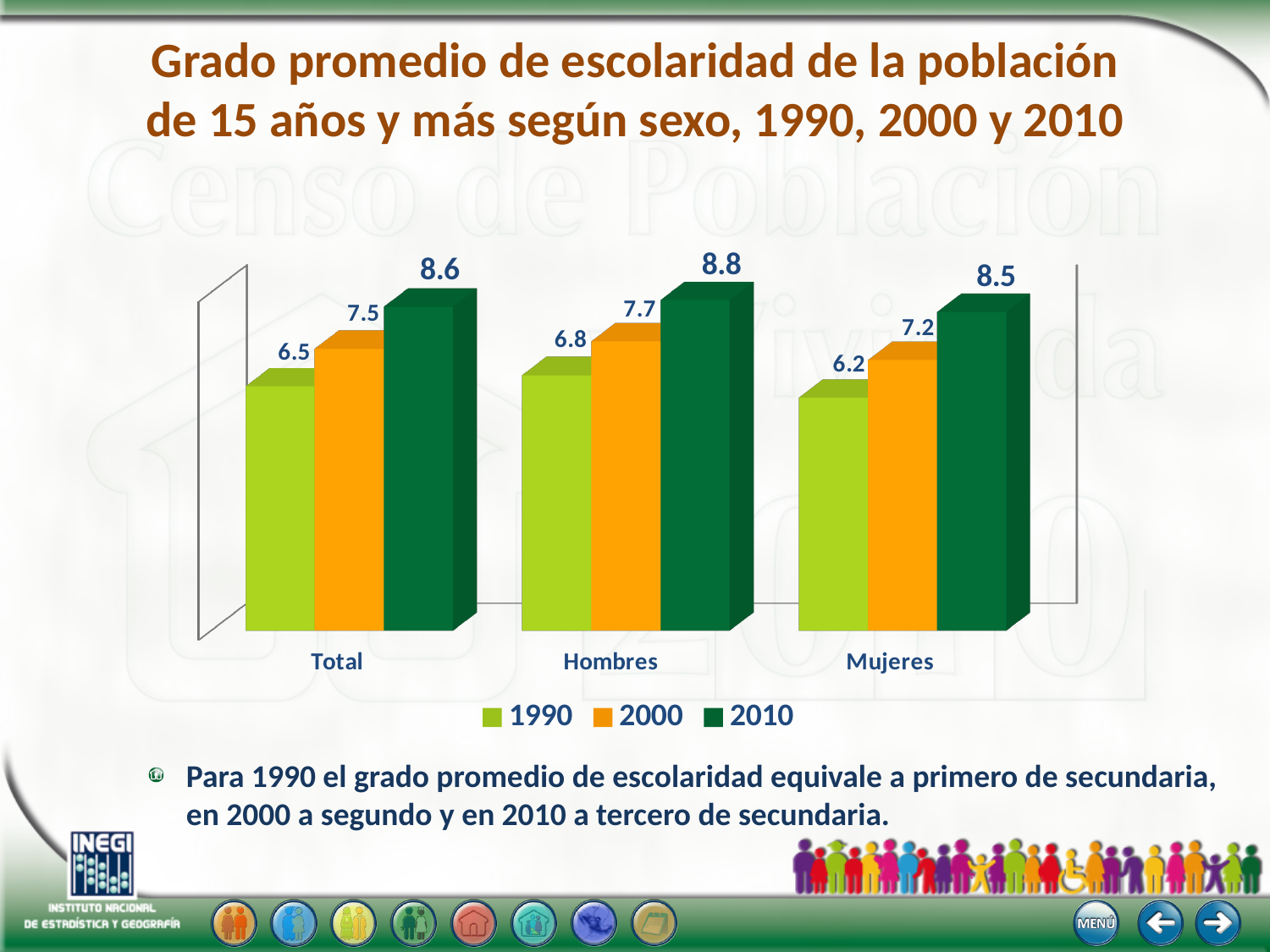
How many series does the legend list? 3 Which category has the lowest value in 1990? Mujeres What is the difference between the 2010 and 1990 values for Total? 2.1 What kind of chart is shown on the slide? Bar chart What is the value for Hombres in 2010? 8.8 Which is larger, the 2000 value for Hombres or the 2000 value for Mujeres? Hombres Which colour represents the 2000 series in the legend? Orange Which category has the highest value in 2010? Hombres What is the value for Mujeres in 1990? 6.2 What is the difference between Hombres and Mujeres in 2000? 0.5 How many categories are shown on the x axis? 3 What is the value for Total in 2000? 7.5